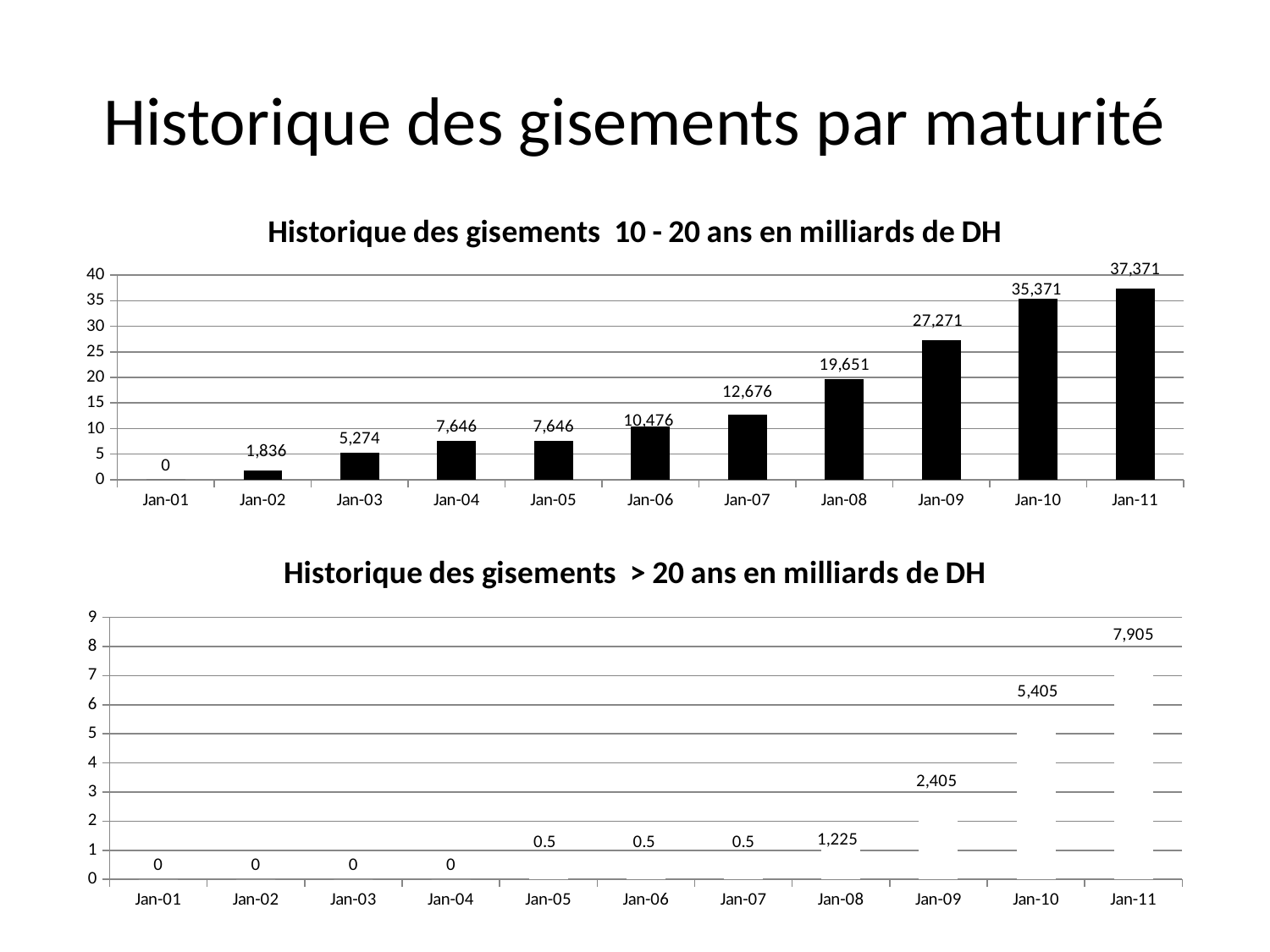
In the bottom chart (> 20 ans), which year has the highest value? Jan-11 In the top chart (10 - 20 ans), do the values generally rise or fall from Jan-01 to Jan-11? rise In the top chart (10 - 20 ans), is the value for Jan-09 greater or less than 25? greater In the top chart (10 - 20 ans), which is larger, the value for Jan-06 or the value for Jan-07? Jan-07 In the top chart (10 - 20 ans), what is the value for Jan-08? 19,651 In the top chart (10 - 20 ans), what is the value for Jan-11? 37,371 What type of chart is the top chart (10 - 20 ans)? bar chart In the bottom chart (> 20 ans), what is the value for Jan-06? 0.5 In the top chart (10 - 20 ans), which year has the lowest value? Jan-01 In the bottom chart (> 20 ans), what is the value for Jan-10? 5,405 In the top chart (10 - 20 ans), which year has the highest value? Jan-11 In the top chart (10 - 20 ans), how many years are shown on the x axis? 11